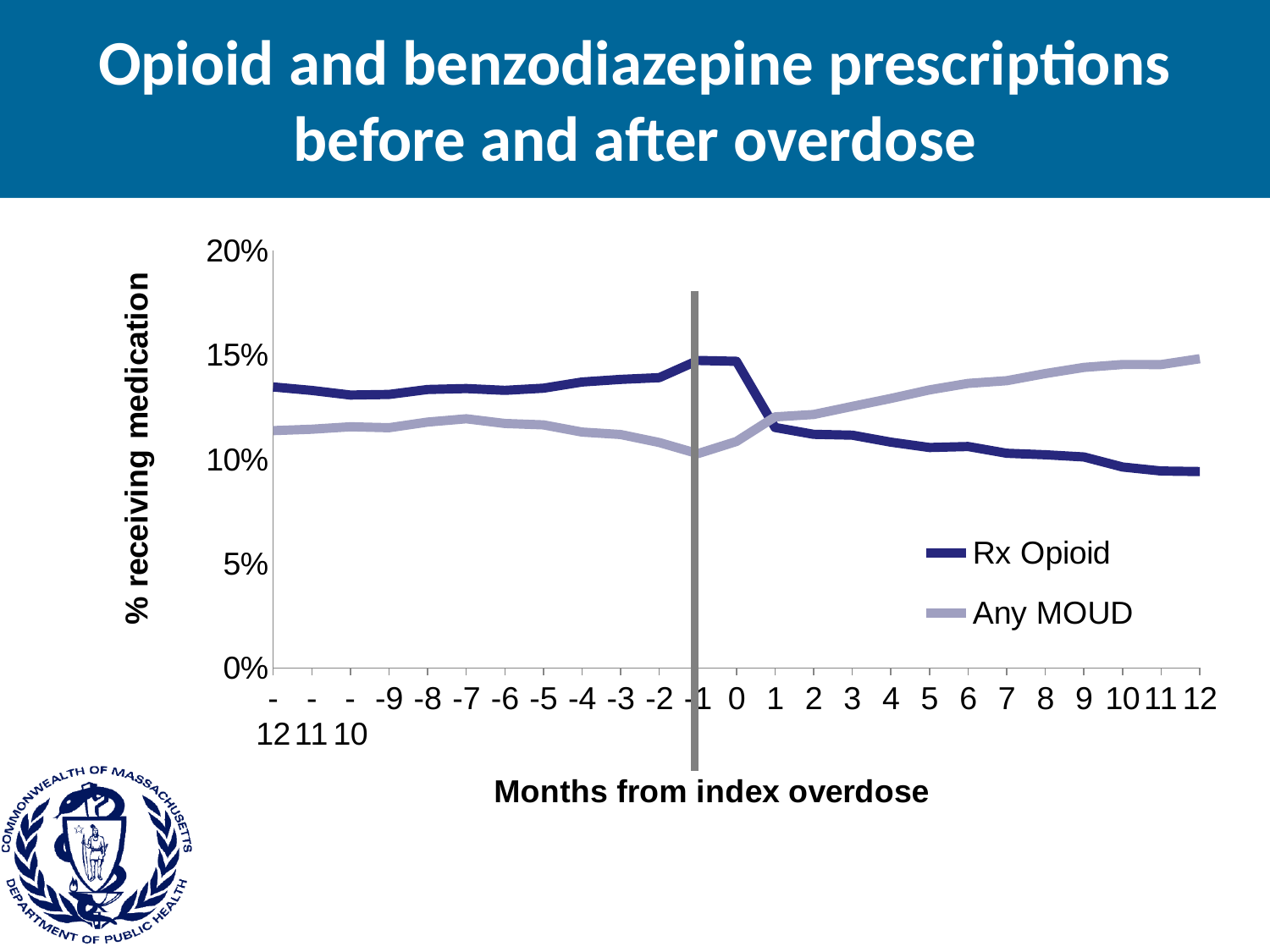
Is the value for Any MOUD at month 12 greater or less than 10%? greater After month 0, does the Any MOUD line rise or fall as months increase? rise How many series does the legend list? 2 At month -12, which series has the higher value, Rx Opioid or Any MOUD? Rx Opioid At month 12, which series has the higher value, Rx Opioid or Any MOUD? Any MOUD Is the value for Rx Opioid at month 0 greater or less than 10%? greater After month 0, does the Rx Opioid line rise or fall as months increase? fall Is the value for Rx Opioid at month 12 greater or less than 10%? less How many months (data points) are plotted along the x axis, from -12 to 12? 25 What kind of chart is shown on the slide? line chart What is the title of the x axis? Months from index overdose